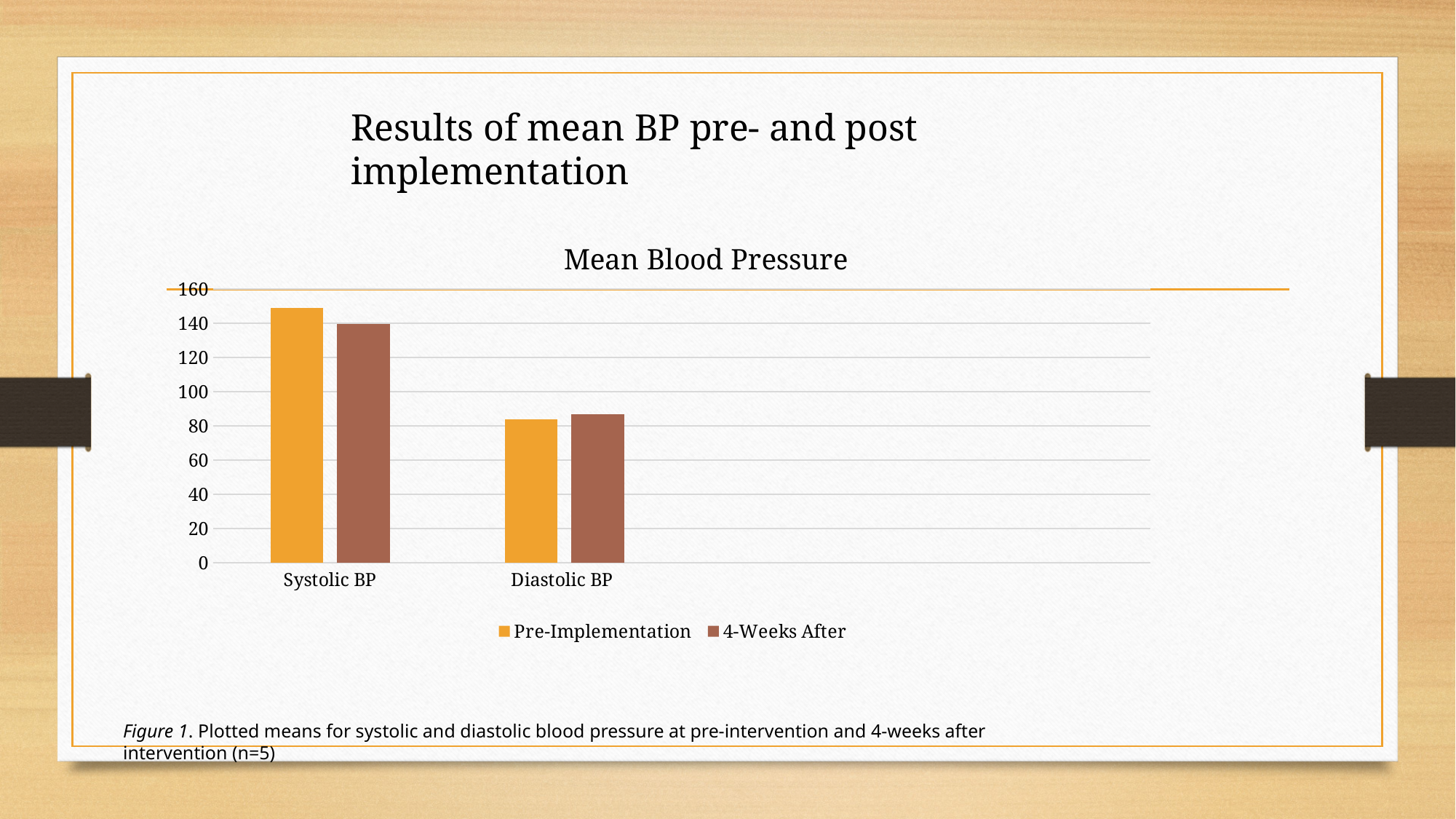
How many series does the legend list? 2 Is the 4-Weeks After value for Systolic BP greater or less than 160? less What kind of chart is shown on the slide? bar chart Is the Pre-Implementation value for Diastolic BP greater or less than 60? greater Is the 4-Weeks After value for Diastolic BP greater or less than 80? greater Which category has the highest Pre-Implementation value? Systolic BP For Systolic BP, which is larger: the Pre-Implementation value or the 4-Weeks After value? Pre-Implementation How many categories are shown on the x axis? 2 What is the title of the chart? Mean Blood Pressure Which series is shown in orange? Pre-Implementation